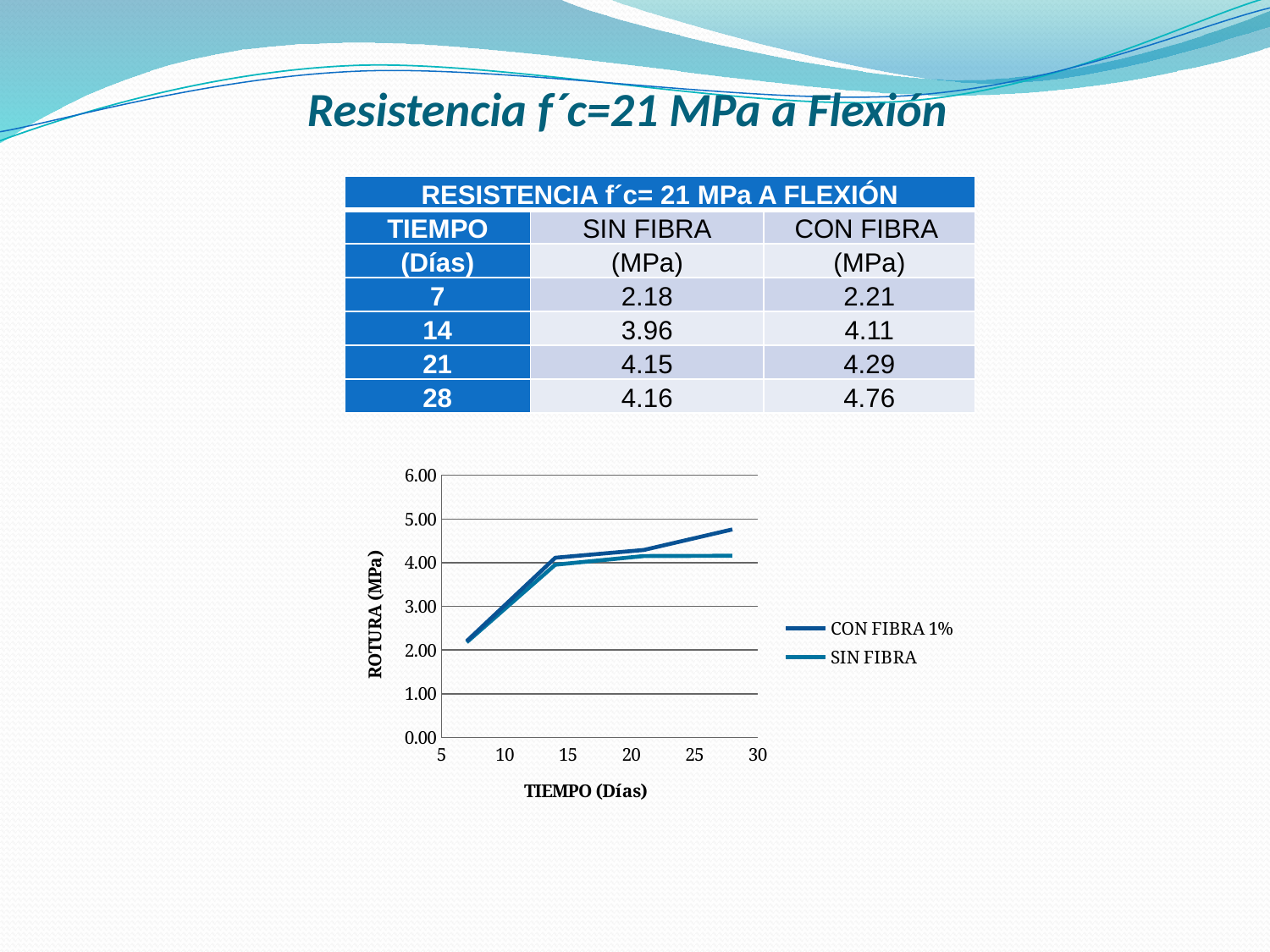
According to the table, what is the difference between the CON FIBRA and SIN FIBRA values at 28 days? 0.60 How many time points (days) are plotted for each series in the chart? 4 What kind of chart is shown on the slide? line chart What are the two series named in the chart legend? CON FIBRA 1% and SIN FIBRA How many series does the chart legend list? 2 Is the value for CON FIBRA 1% at 28 days greater or less than 4.00? greater Is the value for SIN FIBRA at 7 days greater or less than 3.00? less According to the table, what is the CON FIBRA value at 28 days? 4.76 According to the table, what is the SIN FIBRA value at 7 days? 2.18 At 28 days, which series has the higher value, CON FIBRA 1% or SIN FIBRA? CON FIBRA 1% Do the values for CON FIBRA 1% rise or fall as time in days increases? rise What is the label of the vertical axis of the chart? ROTURA (MPa)